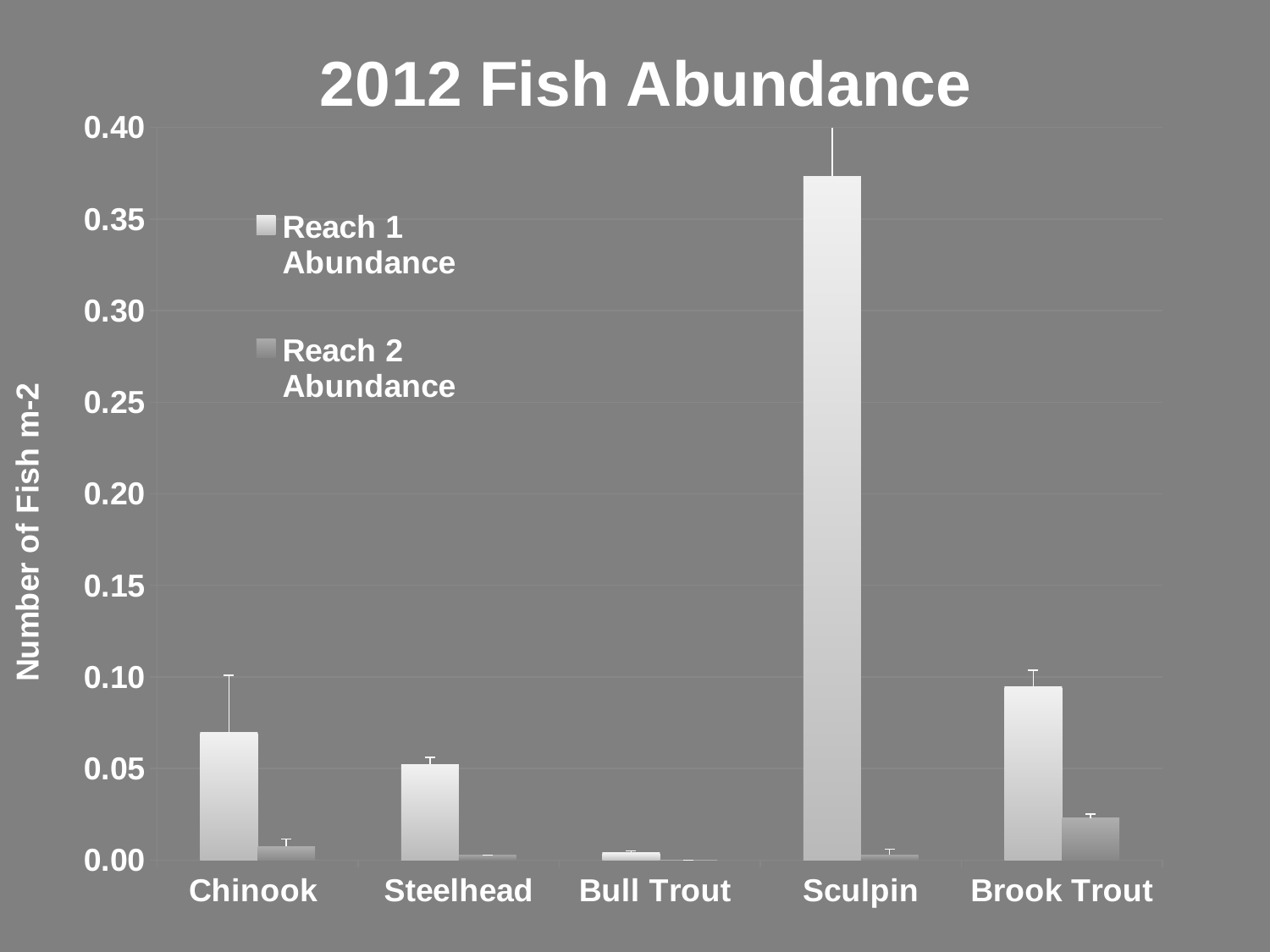
What type of chart is shown on the slide? bar chart Which species has the lowest Reach 1 Abundance? Bull Trout Which species has the highest Reach 2 Abundance? Brook Trout How many series does the legend list? 2 Is the Reach 1 Abundance for Sculpin greater or less than 0.35? greater What is the label of the y axis? Number of Fish m-2 How many fish species categories are shown on the x axis? 5 What is the title of the chart? 2012 Fish Abundance Is the Reach 1 Abundance for Chinook greater or less than 0.05? greater Which is larger, the Reach 1 Abundance for Chinook or for Steelhead? Chinook Is the Reach 1 Abundance for Brook Trout greater or less than 0.10? less Which species has the highest Reach 1 Abundance? Sculpin